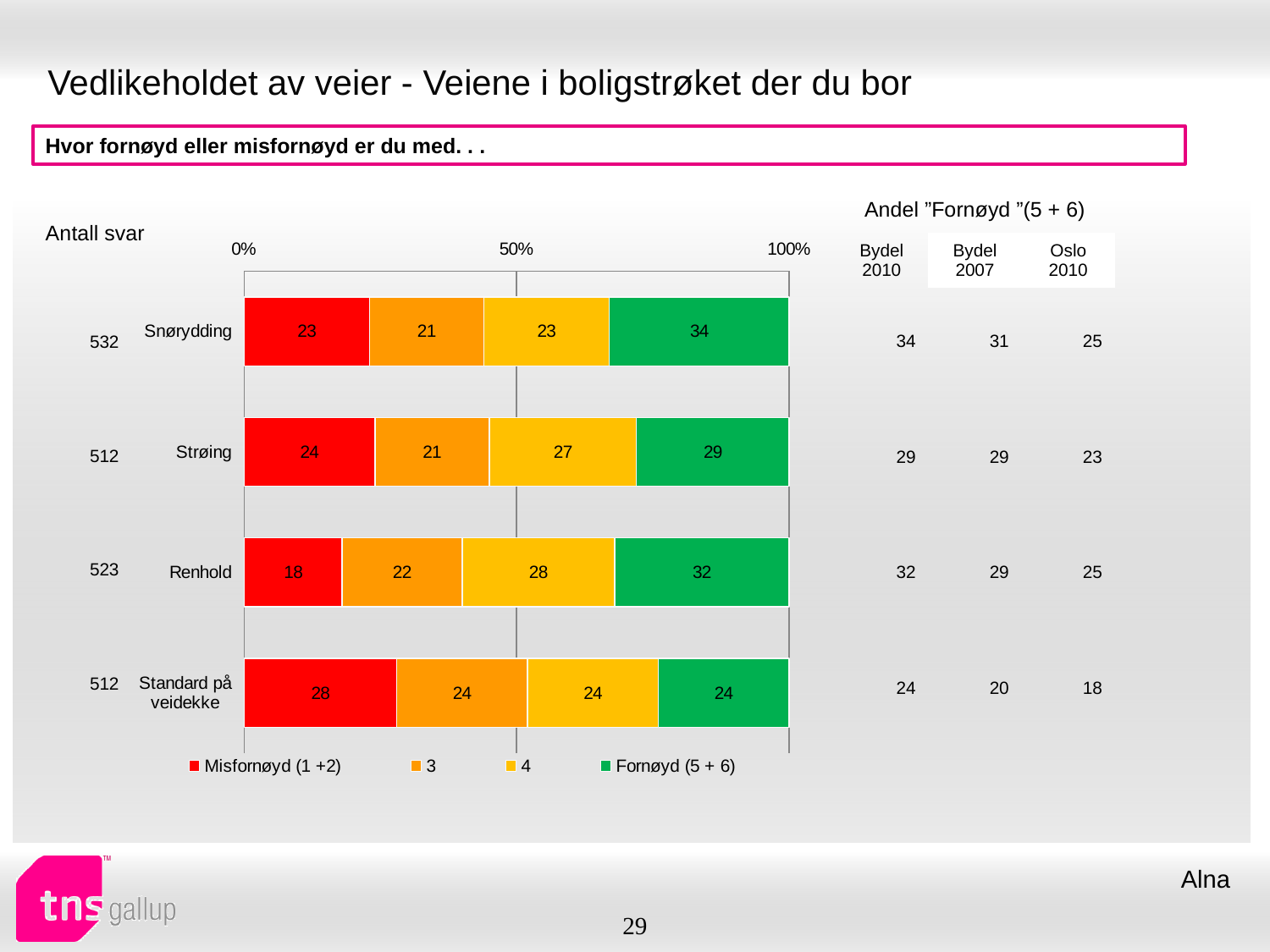
What is the difference between the Misfornøyd (1 +2) values for Standard på veidekke and Renhold? 10 How many series does the chart legend list? 4 What is the value of the Fornøyd (5 + 6) segment for Snørydding? 34 What is the value of the Misfornøyd (1 +2) segment for Renhold? 18 Which category has the lowest Misfornøyd (1 +2) value? Renhold Which category has the highest Fornøyd (5 + 6) value? Snørydding Which is larger: the Fornøyd (5 + 6) value for Renhold or for Strøing? Renhold What is the total of the stacked bar for Standard på veidekke? 100 How many categories are plotted in the chart? 4 Which colour represents the Fornøyd (5 + 6) series in the chart? Green What kind of chart is shown on the slide? Stacked bar chart What is the value of the segment labelled 4 for Strøing? 27